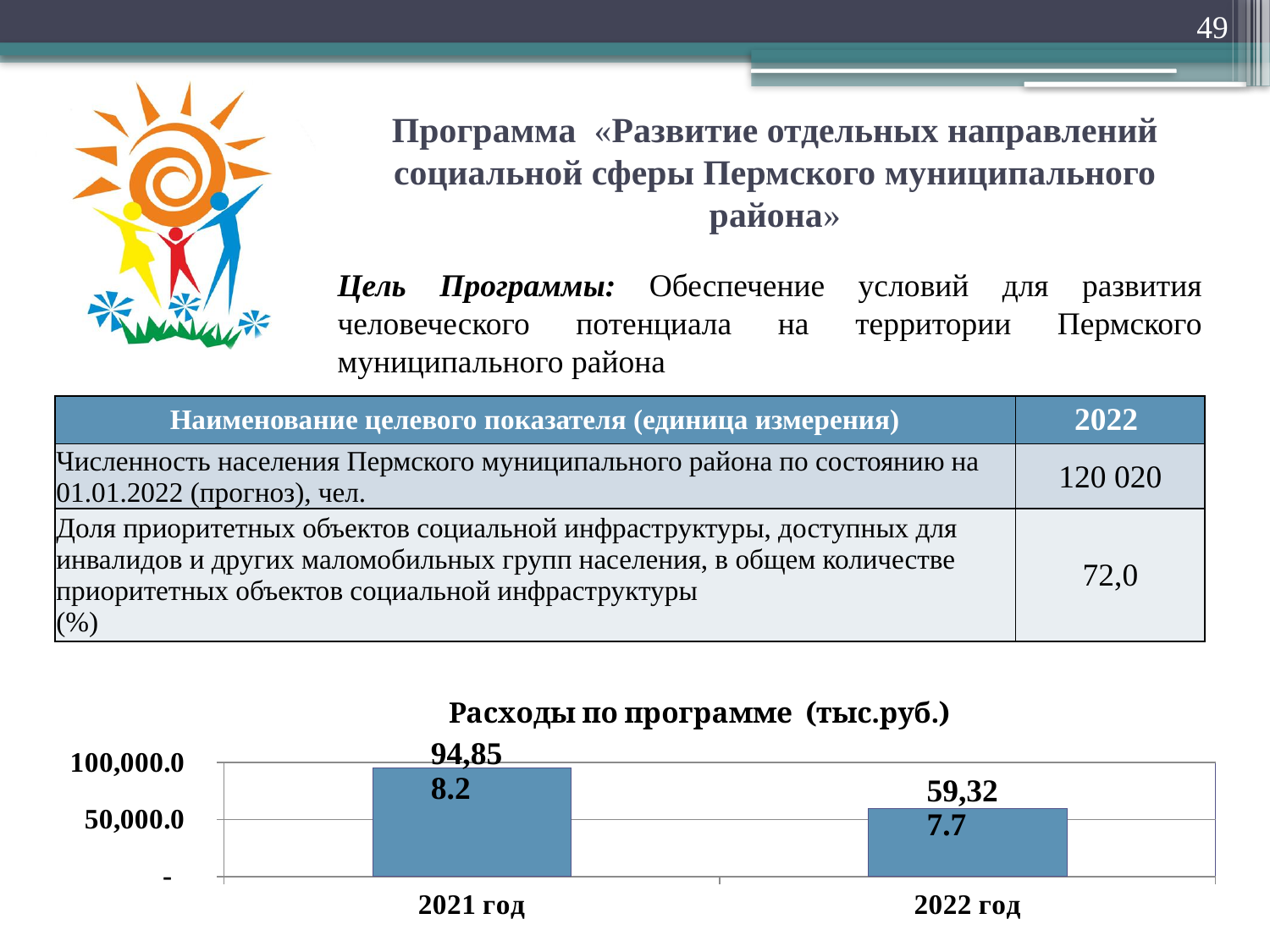
Is the value for 2022 год greater or less than 100,000.0? less How many categories (years) are shown in the chart? 2 Which year has the highest expenditure in the chart? 2021 год Is the value for 2021 год greater or less than 50,000.0? greater What is the title of the chart? Расходы по программе (тыс.руб.) Which is larger, the value for 2021 год or for 2022 год? 2021 год What kind of chart is shown on the slide? bar chart What is the difference between the values for 2021 год and 2022 год? 35,530.5 What is the value for 2021 год in the chart? 94,858.2 Do the values rise or fall from 2021 год to 2022 год? fall What is the value for 2022 год in the chart? 59,327.7 Which year has the lowest expenditure in the chart? 2022 год